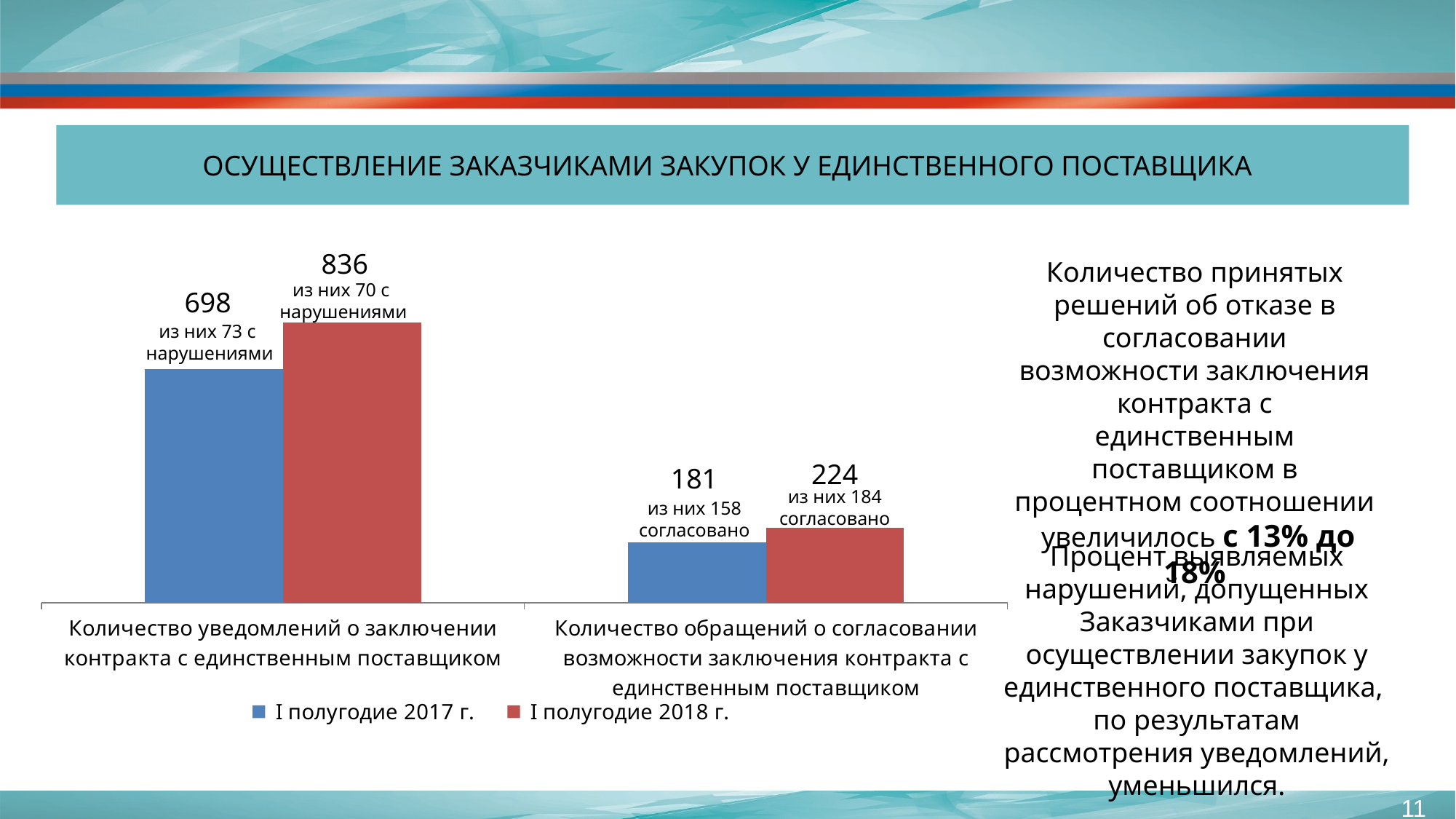
What kind of chart is shown on the slide? Bar chart How many categories are shown on the x axis of the chart? 2 What is the value for 'I полугодие 2017 г.' in the category 'Количество обращений о согласовании возможности заключения контракта с единственным поставщиком'? 181 How many series does the legend list? 2 What is the difference between the 2018 and 2017 values for 'Количество обращений о согласовании возможности заключения контракта с единственным поставщиком'? 43 Which is larger: the 2017 value for 'Количество уведомлений о заключении контракта с единственным поставщиком' or the 2018 value for 'Количество обращений о согласовании возможности заключения контракта с единственным поставщиком'? 2017 value for Количество уведомлений (698) What is the difference between the 2018 and 2017 values for 'Количество уведомлений о заключении контракта с единственным поставщиком'? 138 What is the value for 'I полугодие 2018 г.' in the category 'Количество уведомлений о заключении контракта с единственным поставщиком'? 836 Which bar has the highest value on the chart? I полугодие 2018 г., Количество уведомлений о заключении контракта с единственным поставщиком (836) What is the value for 'I полугодие 2018 г.' in the category 'Количество обращений о согласовании возможности заключения контракта с единственным поставщиком'? 224 What is the value for 'I полугодие 2017 г.' in the category 'Количество уведомлений о заключении контракта с единственным поставщиком'? 698 Which bar has the lowest value on the chart? I полугодие 2017 г., Количество обращений о согласовании возможности заключения контракта с единственным поставщиком (181)